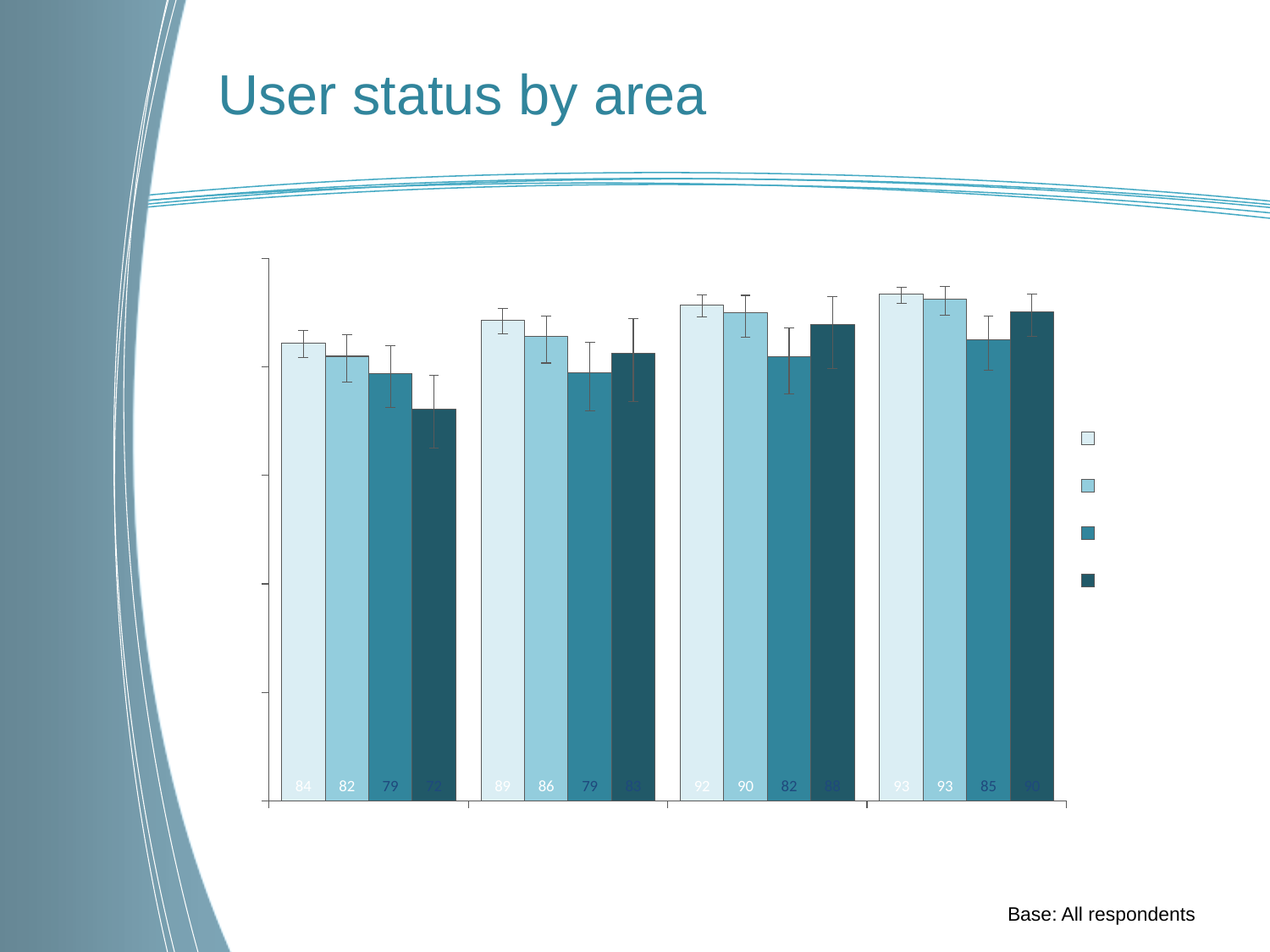
What is the value of the lightest-coloured bar in the rightmost group? 93 How many series does the legend list? 4 What is the difference between the lightest bar (84) and the second-lightest bar (82) in the leftmost group? 2 How many groups of bars are plotted along the x axis? 4 What is the value of the third (medium-dark) bar in the third group from the left? 82 Which group has the highest value for the lightest-coloured series? the rightmost group (93) What is the value of the lightest-coloured bar in the leftmost group? 84 Which is larger: the lightest bar in the third group from the left or the lightest bar in the second group from the left? the third group (92 vs 89) Do the values of the lightest-coloured series rise or fall from left to right across the groups? rise What is the title of the chart on the slide? User status by area What is the value of the second-lightest bar in the second group from the left? 86 What kind of chart is shown on the slide? bar chart